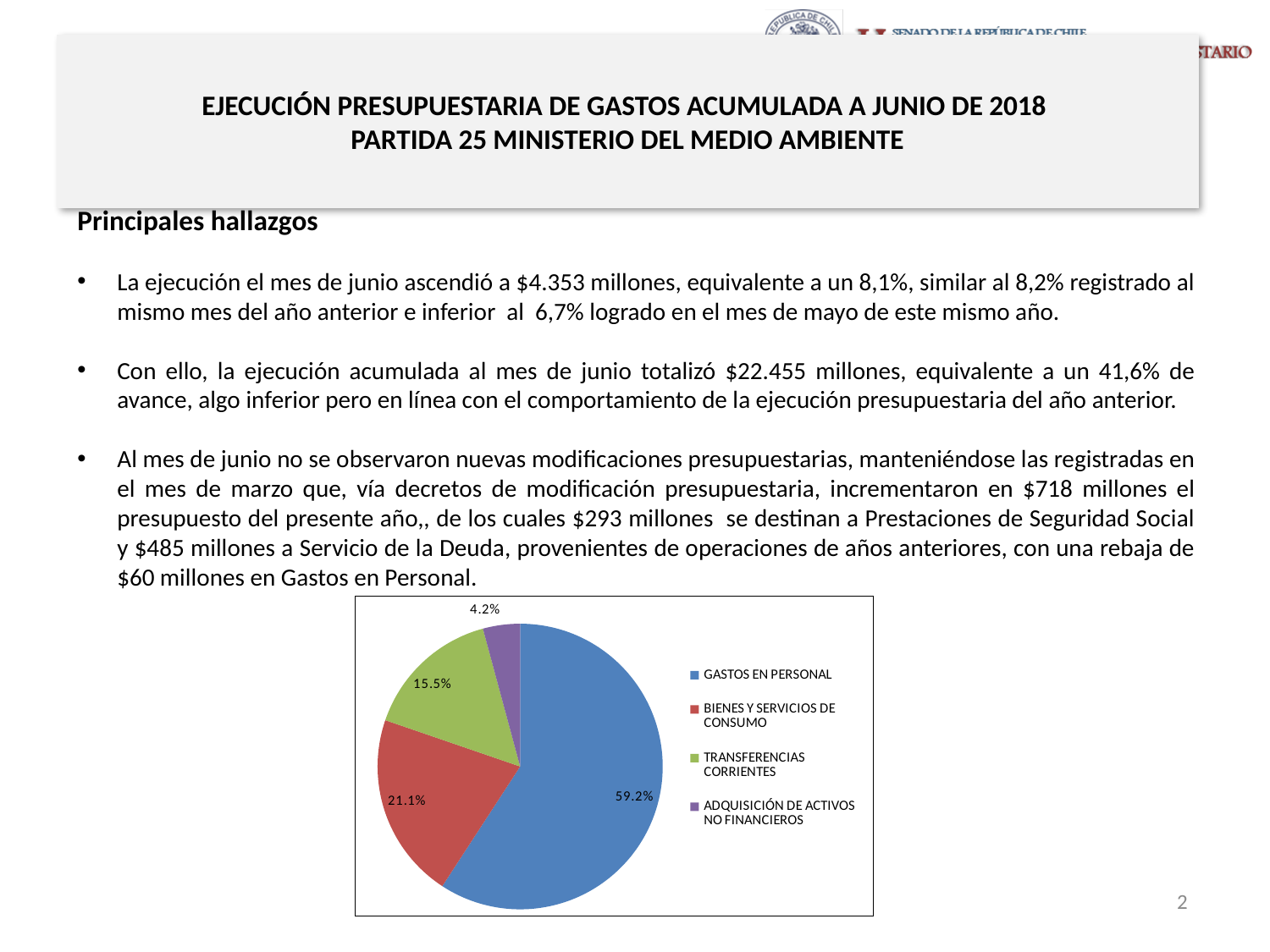
What share of the pie does BIENES Y SERVICIOS DE CONSUMO represent? 21.1% Which is larger, the share for TRANSFERENCIAS CORRIENTES or the share for BIENES Y SERVICIOS DE CONSUMO? BIENES Y SERVICIOS DE CONSUMO Which category has the largest slice of the pie? GASTOS EN PERSONAL Which category has the smallest slice of the pie? ADQUISICIÓN DE ACTIVOS NO FINANCIEROS What kind of chart is shown on the slide? Pie chart What colour is the slice for TRANSFERENCIAS CORRIENTES? Green What share of the pie does TRANSFERENCIAS CORRIENTES represent? 15.5% What is the difference in percentage points between TRANSFERENCIAS CORRIENTES and ADQUISICIÓN DE ACTIVOS NO FINANCIEROS? 11.3 percentage points How many categories does the pie chart show? 4 What share of the pie does GASTOS EN PERSONAL represent? 59.2% What is the difference in percentage points between GASTOS EN PERSONAL and BIENES Y SERVICIOS DE CONSUMO? 38.1 percentage points